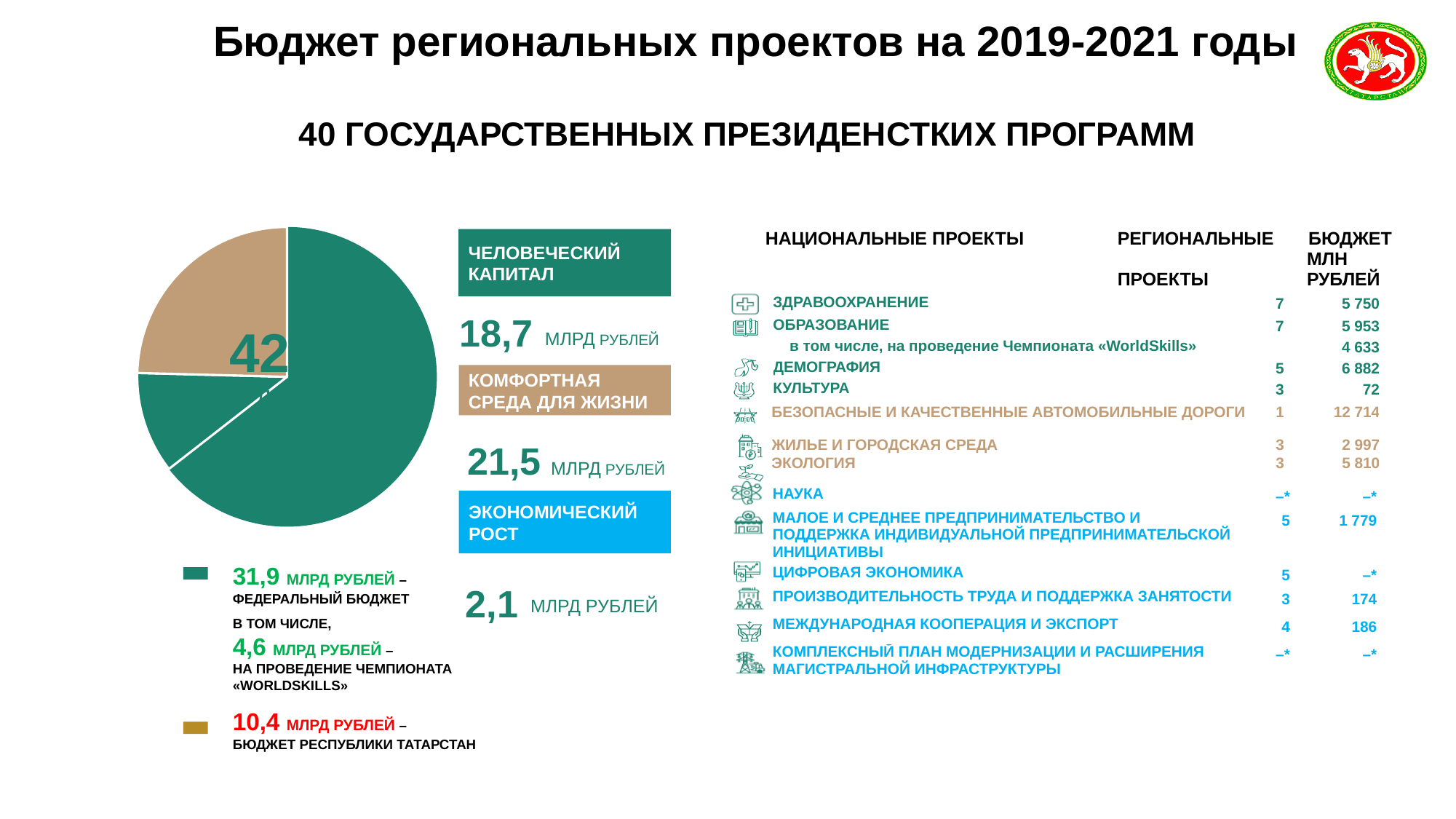
What kind of chart is shown on the left of the slide? pie chart In the pie chart, which is larger: the federal budget or the budget of the Republic of Tatarstan? федеральный бюджет What number is printed in the centre of the pie chart? 42 Which slice of the pie chart is the smallest? the small green slice for the WorldSkills championship (4,6 млрд рублей) Which slice of the pie chart is the largest? федеральный бюджет In the pie chart, what value is given for БЮДЖЕТ РЕСПУБЛИКИ ТАТАРСТАН? 10,4 млрд рублей In the pie chart, what value is given for ФЕДЕРАЛЬНЫЙ БЮДЖЕТ? 31,9 млрд рублей By how much does the federal budget exceed the budget of the Republic of Tatarstan in the pie chart? 21,5 млрд рублей What colour represents the federal budget in the pie chart? green How many entries does the legend of the pie chart list? 2 According to the pie chart legend, how much of the federal budget is for holding the WorldSkills championship? 4,6 млрд рублей